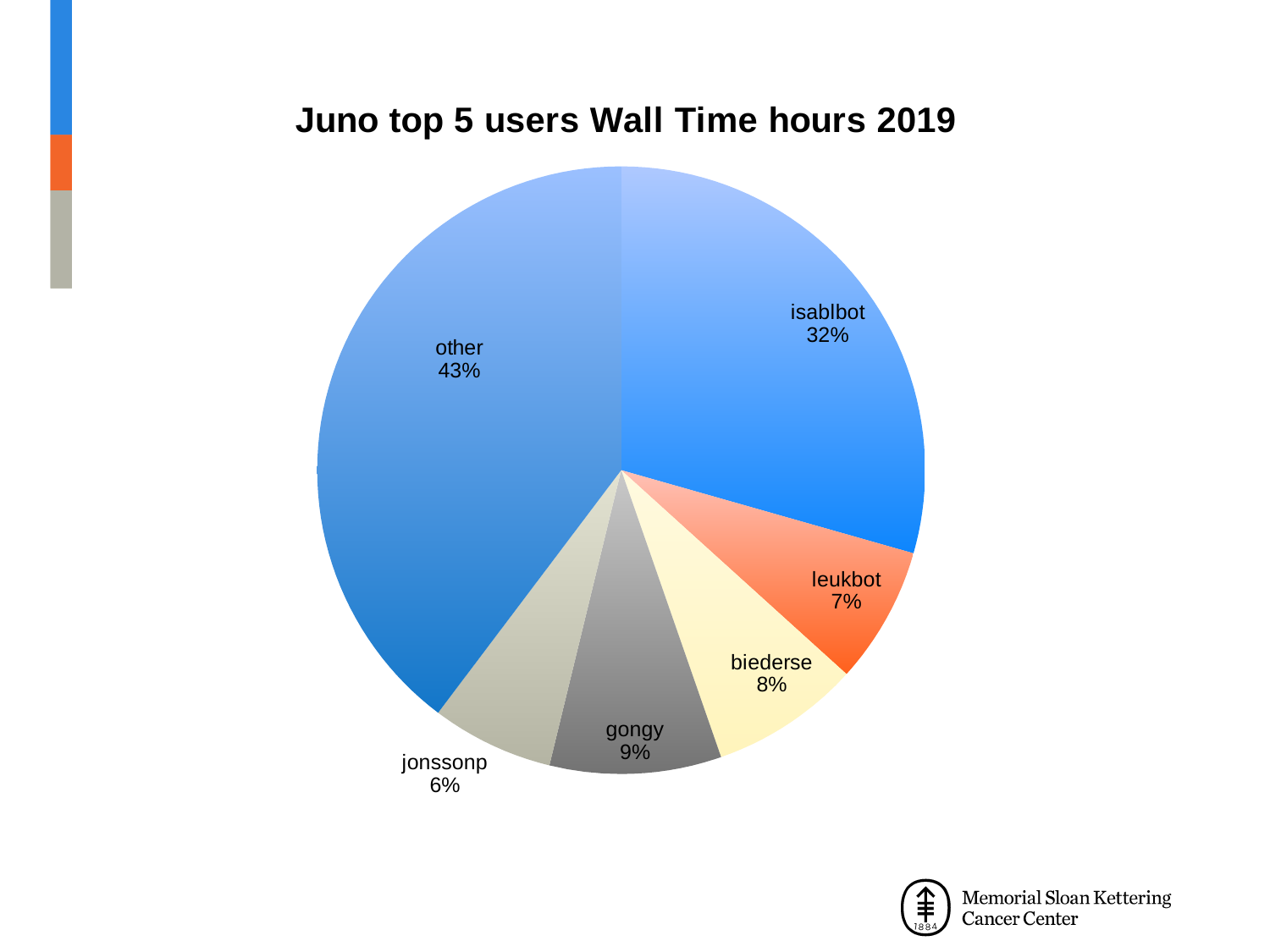
What share of the pie does gongy have? 9% What is the difference in percentage points between other and isablbot? 11 What is the combined share of gongy and biederse? 17% What share of the pie does leukbot have? 7% How many slices does the pie chart have? 6 What share of the pie does jonssonp have? 6% Which slice is the smallest? jonssonp Which slice is the largest? other What is the title of the chart? Juno top 5 users Wall Time hours 2019 Which is larger, biederse or leukbot? biederse What type of chart is shown on the slide? pie chart